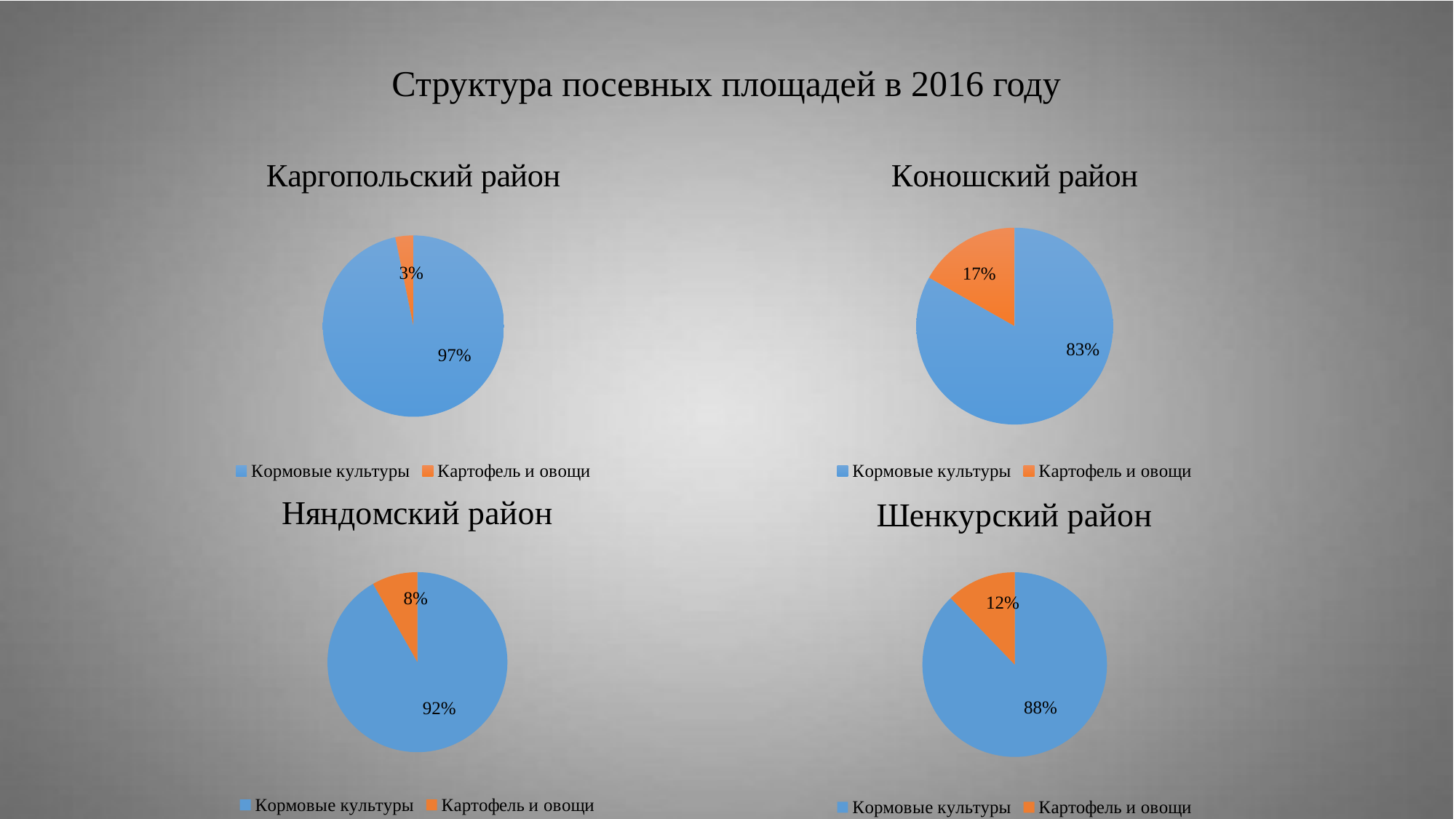
In the Коношский район chart, what share of the pie is Картофель и овощи? 17% In the Коношский район chart, what share of the pie is Кормовые культуры? 83% How many entries does the legend of the Няндомский район chart list? 2 In the Каргопольский район chart, what share of the pie is Кормовые культуры? 97% What kind of chart is used for Каргопольский район? Pie chart How many slices does the Шенкурский район chart have? 2 In the Няндомский район chart, which slice is larger, Кормовые культуры or Картофель и овощи? Кормовые культуры In the Коношский район chart, which category has the smallest slice? Картофель и овощи In the Шенкурский район chart, what is the difference between the Кормовые культуры and Картофель и овощи shares? 76%